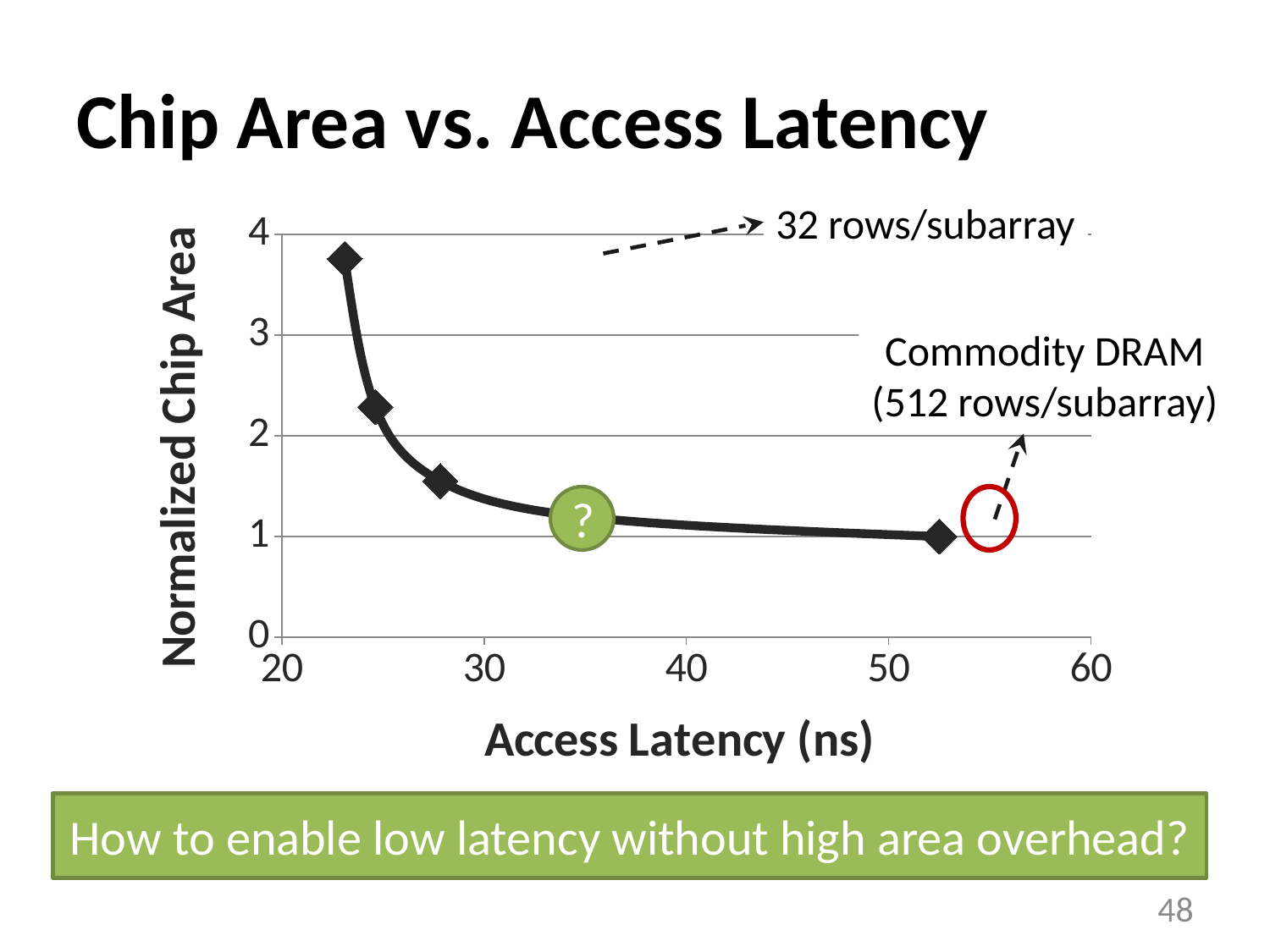
Is the normalized chip area for the leftmost data point (lowest latency) greater or less than 3? greater As access latency increases along the x axis, does normalized chip area rise or fall? fall Is the normalized chip area for the third data point from the left greater or less than 2? less Which data point has the highest normalized chip area: the one with the lowest access latency or the one with the highest access latency? the one with the lowest access latency Is the access latency of the leftmost data point greater or less than 30 ns? less What is the label of the x axis? Access Latency (ns) What kind of chart is shown on the slide? line chart According to the annotation, how many rows per subarray does commodity DRAM have? 512 rows/subarray